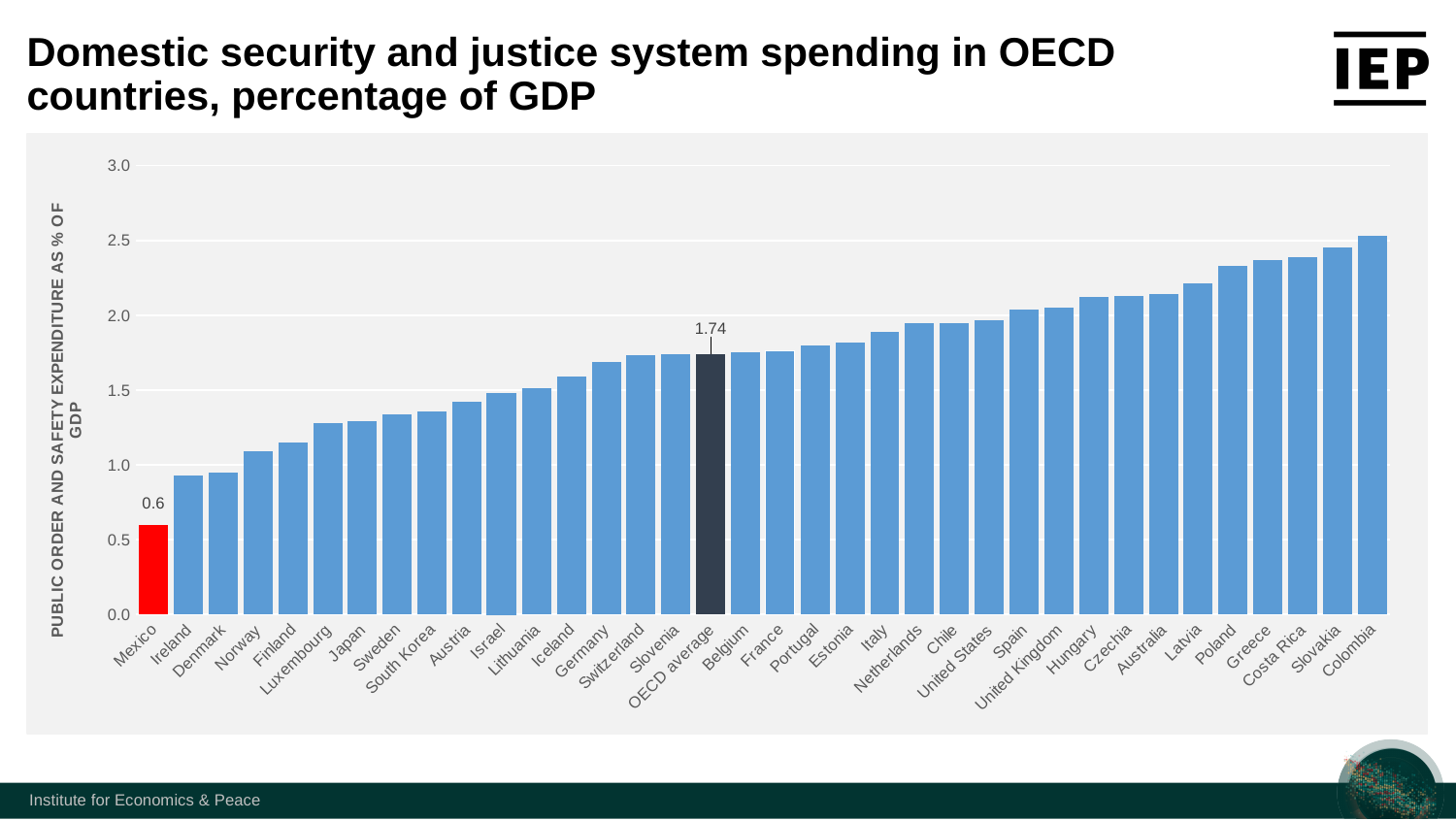
Is the value for Japan greater or less than 1.5? less Which bar is coloured red? Mexico What is the value for the OECD average? 1.74 What kind of chart is shown on the slide? bar chart How many bars are plotted in the chart? 36 What is the difference between the OECD average and Mexico's value? 1.14 Is the value for Ireland greater or less than 1.0? less What is the value for Mexico? 0.6 Which has a larger value, Greece or Japan? Greece Which country has the lowest public order and safety expenditure as % of GDP? Mexico Which country has the highest public order and safety expenditure as % of GDP? Colombia Is the value for Colombia greater or less than 2.0? greater